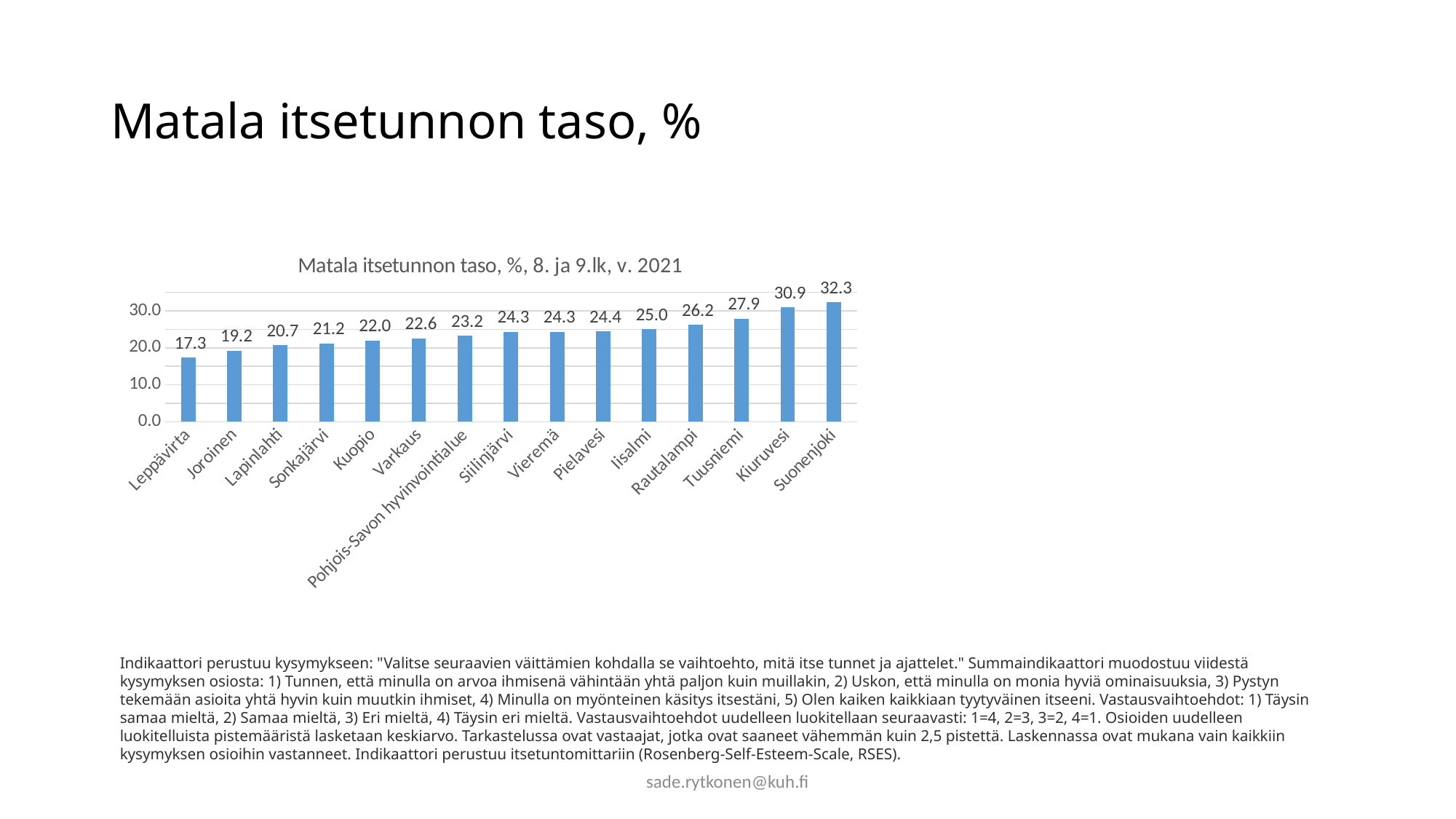
What is the difference between the values for Suonenjoki and Leppävirta? 15.0 What is the value for Kuopio? 22.0 Which category has the lowest value? Leppävirta Which is larger, the value for Rautalampi or the value for Iisalmi? Rautalampi Is the value for Joroinen greater or less than 20.0? less Do the values rise or fall from left to right along the x axis? rise What kind of chart is shown? bar chart Which category has the highest value? Suonenjoki What is the difference between the values for Kiuruvesi and Tuusniemi? 3.0 What is the title of the chart? Matala itsetunnon taso, %, 8. ja 9.lk, v. 2021 What is the value for Pohjois-Savon hyvinvointialue? 23.2 How many categories are shown on the x axis? 15